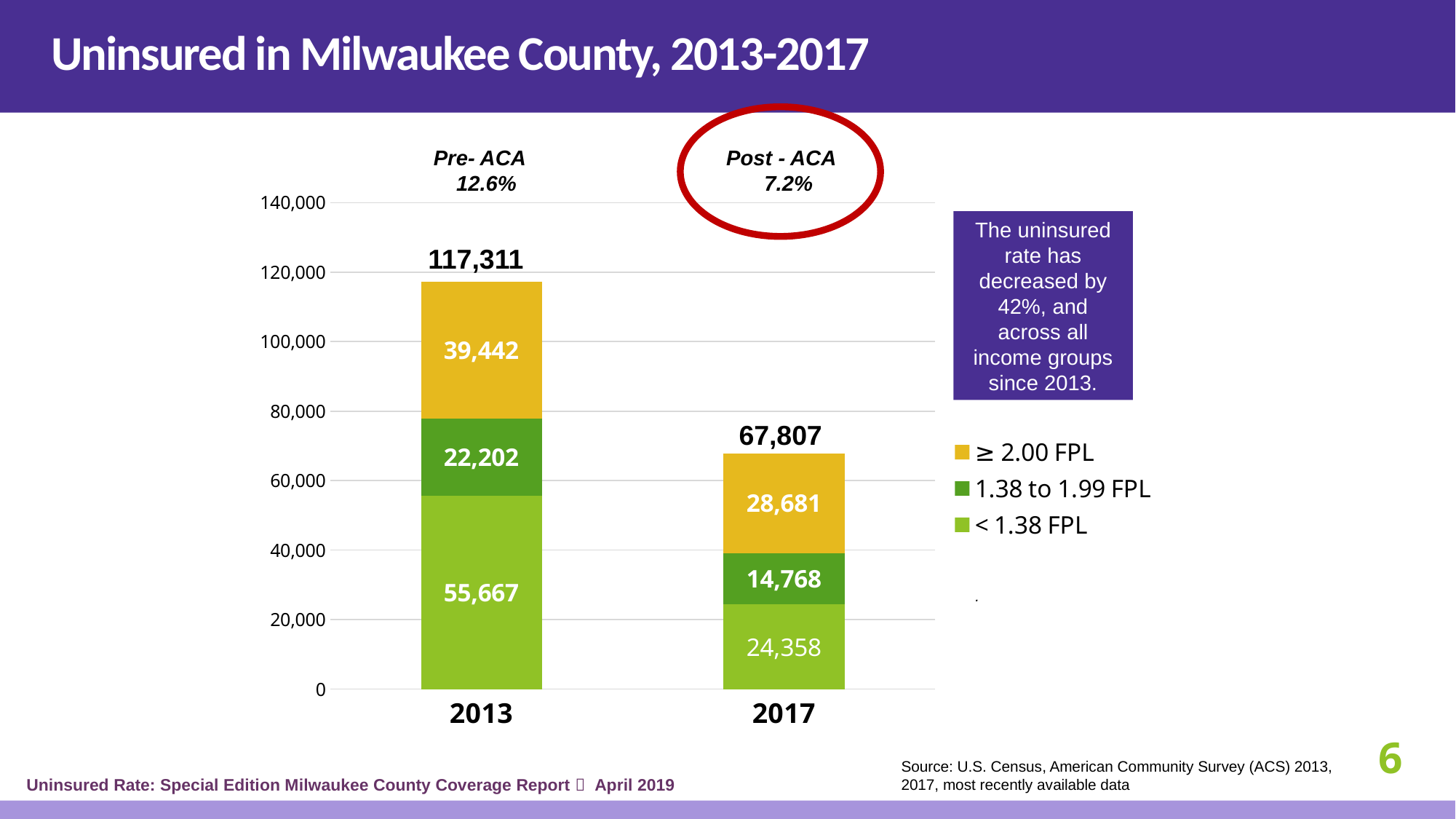
Which income group has the smallest value in 2013? 1.38 to 1.99 FPL What uninsured rate is shown for Post-ACA? 7.2% What is the total of the stacked bar for 2017? 67,807 How many series does the legend list? 3 Which year has the higher total number of uninsured? 2013 What is the value for 1.38 to 1.99 FPL in 2017? 14,768 What is the value for < 1.38 FPL in 2013? 55,667 What is the difference between the < 1.38 FPL values for 2013 and 2017? 31,309 What is the total of the stacked bar for 2013? 117,311 Which income group has the largest value in 2017? ≥ 2.00 FPL What is the value for ≥ 2.00 FPL in 2017? 28,681 What kind of chart is shown? Stacked bar chart